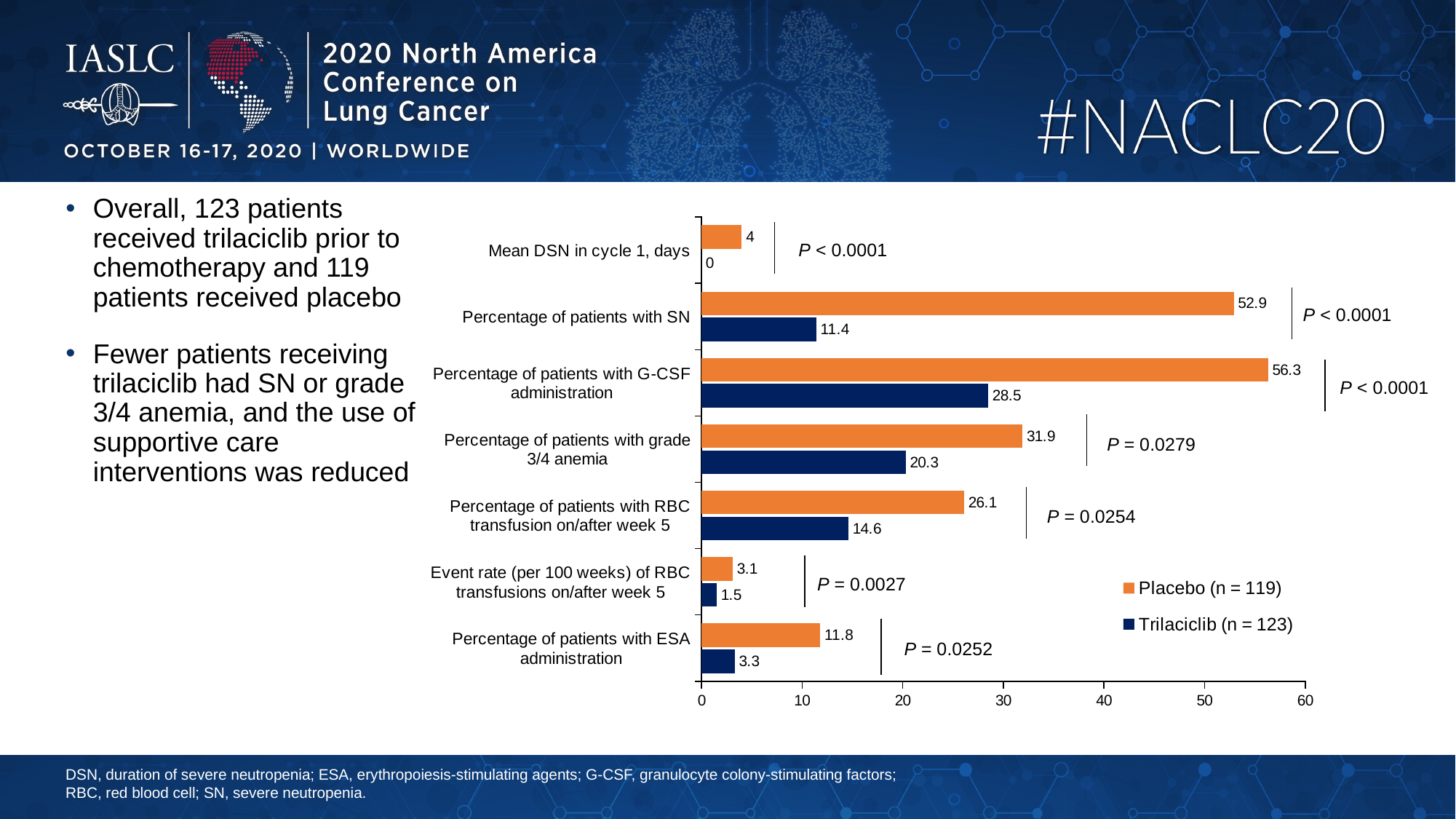
What is the Trilaciclib value for Percentage of patients with G-CSF administration? 28.5 What kind of chart is shown on the slide? Bar chart How many series does the legend list? 2 What is the difference between the Placebo and Trilaciclib values for Percentage of patients with grade 3/4 anemia? 11.6 Which category has the highest Placebo value? Percentage of patients with G-CSF administration How many categories are shown on the chart? 7 What is the Placebo value for Percentage of patients with SN? 52.9 Which colour represents Trilaciclib (n = 123) in the legend? Dark blue Which category has the lowest Trilaciclib value? Mean DSN in cycle 1, days What is the Trilaciclib value for Mean DSN in cycle 1, days? 0 Which is larger for Percentage of patients with RBC transfusion on/after week 5: the Placebo value or the Trilaciclib value? Placebo What P value is shown for Percentage of patients with ESA administration? P = 0.0252